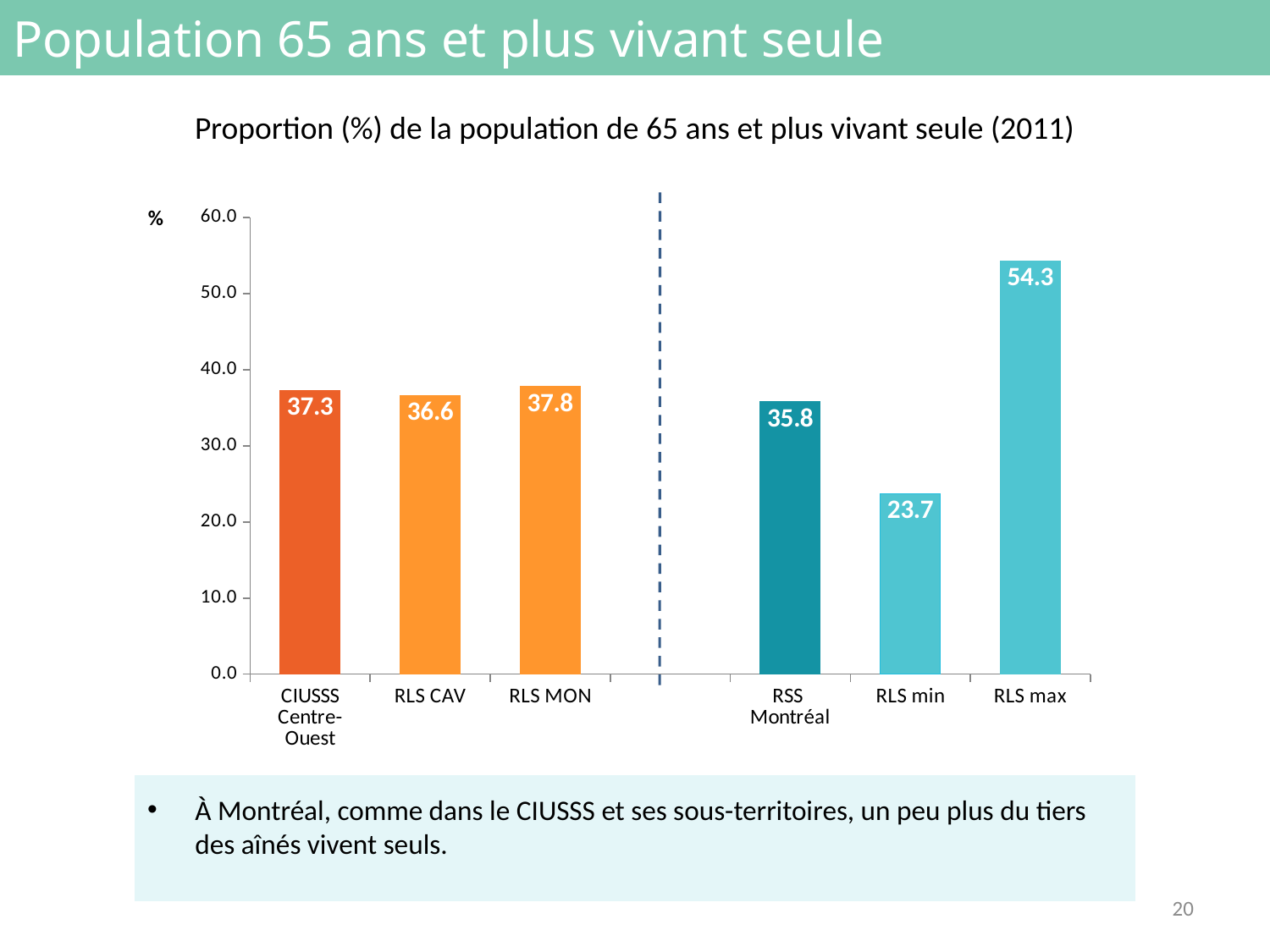
What is the value for RLS CAV? 36.6 What is the value for CIUSSS Centre-Ouest? 37.3 How many categories are shown on the chart? 6 What is the difference between the values for RLS max and RLS min? 30.6 Which category has the highest value? RLS max What is the value for RLS min? 23.7 Is the value for RLS max greater or less than 50.0? greater What is the value for RSS Montréal? 35.8 Which category has the lowest value? RLS min What is the difference between the values for RLS MON and RSS Montréal? 2.0 Which is larger, the value for RLS MON or the value for RLS CAV? RLS MON What kind of chart is shown on the slide? Bar chart